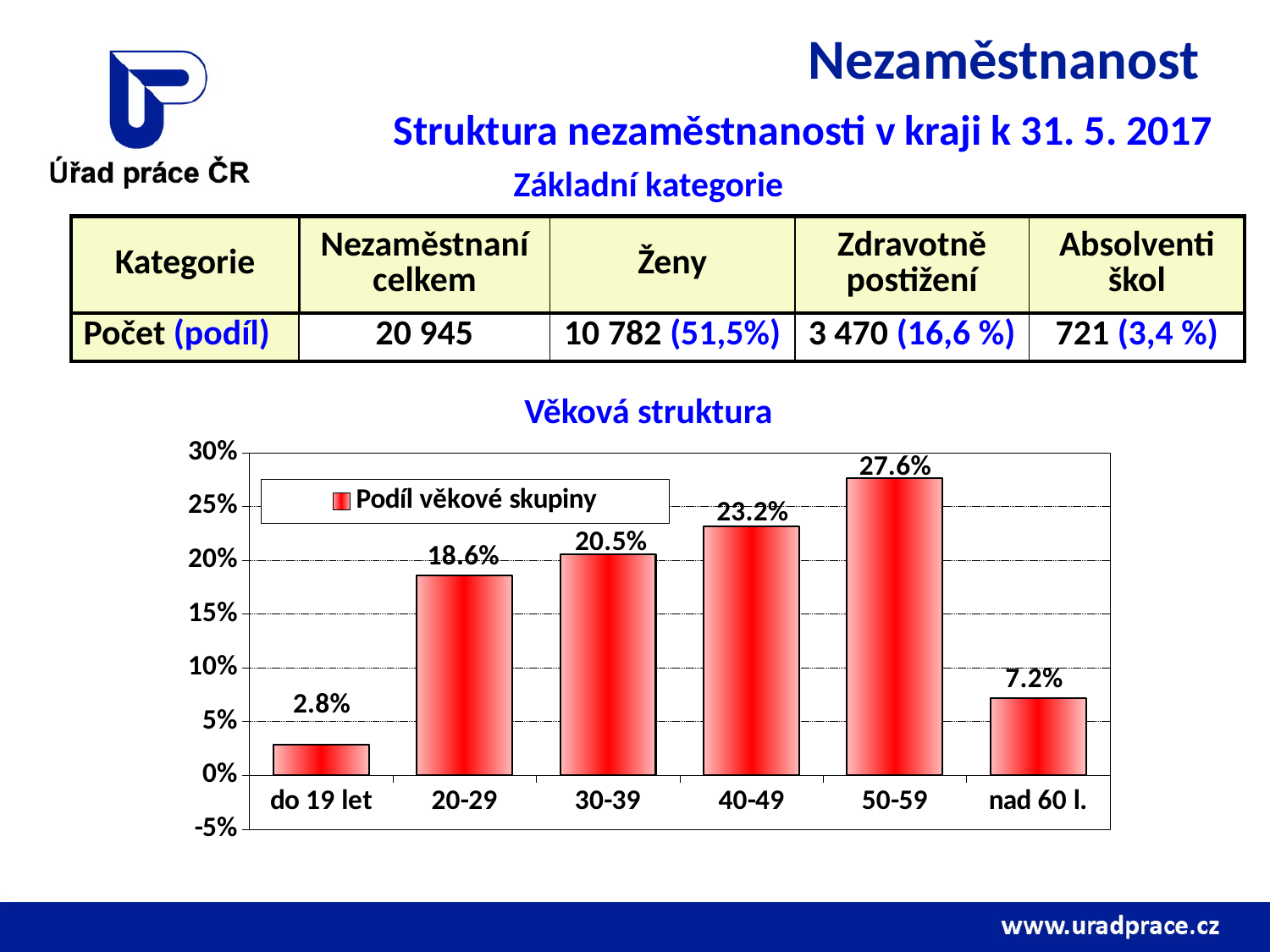
What is the value for the 50-59 age group in the Věková struktura chart? 27.6% Which age group has the lowest share in the Věková struktura chart? do 19 let What is the value for the 30-39 age group in the Věková struktura chart? 20.5% Which is larger in the Věková struktura chart: the value for 20-29 or for nad 60 l.? 20-29 How many series does the legend of the Věková struktura chart list? 1 Which age group has the highest share in the Věková struktura chart? 50-59 What is the difference between the 50-59 and 40-49 values in the Věková struktura chart? 4.4% What is the legend entry in the Věková struktura chart? Podíl věkové skupiny Is the value for 40-49 in the Věková struktura chart greater or less than 20%? greater How many age categories are shown in the Věková struktura chart? 6 What is the value for the 'do 19 let' category in the Věková struktura chart? 2.8% What kind of chart is the Věková struktura chart? bar chart